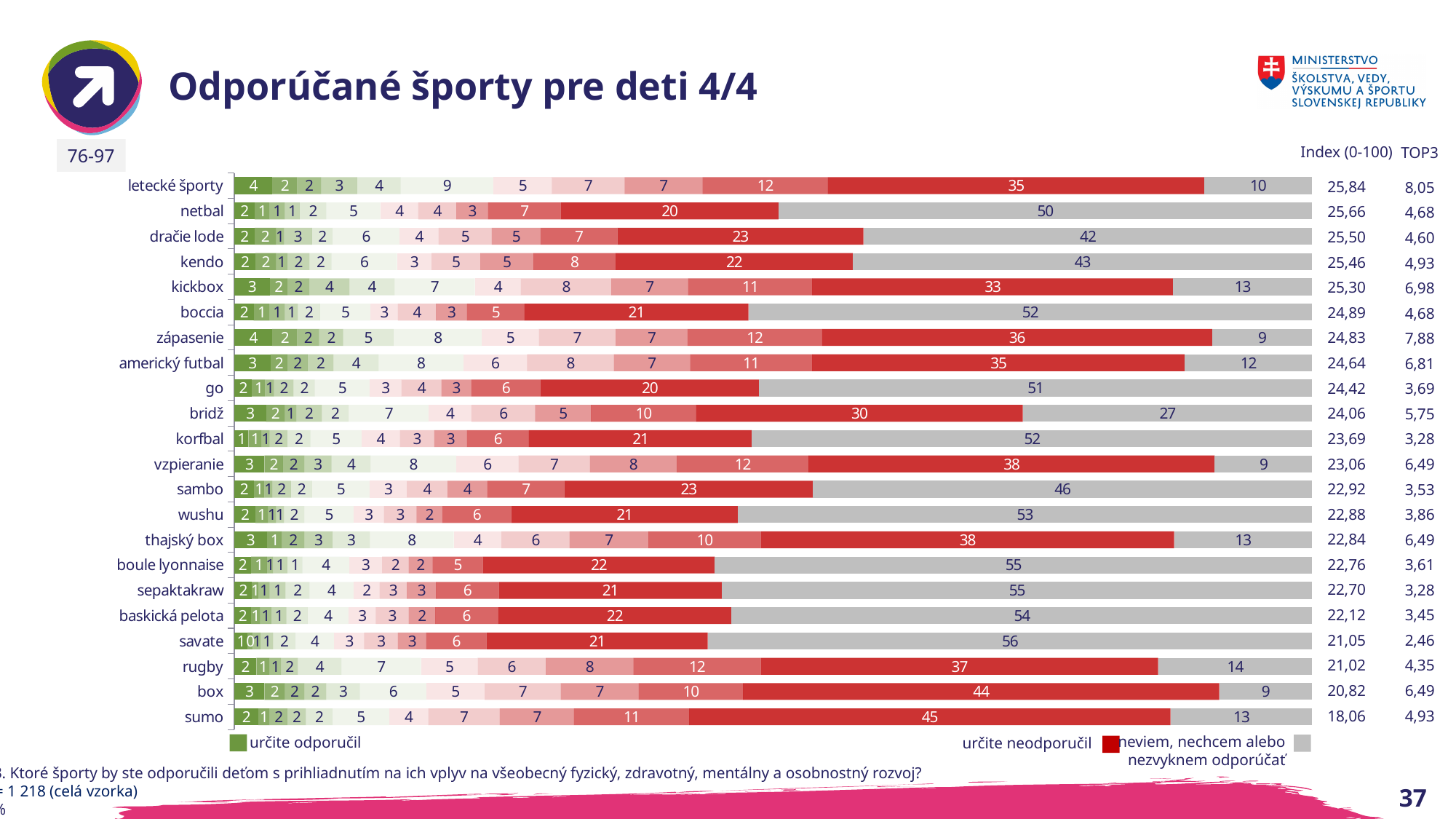
What is the value of the grey segment (neviem, nechcem alebo nezvyknem odporúčať) for savate? 56 What is the value of the red 'určite neodporučil' segment for box? 44 What is the difference between the grey segment values for boccia and netbal? 2 Which sport has the highest TOP3 value? letecké športy Which sport has the lowest Index (0-100) value? sumo What is the Index (0-100) value for letecké športy? 25,84 What is the TOP3 value for zápasenie? 7,88 How many sports are listed in the chart? 22 What kind of chart is shown on the slide? bar chart Which sport has the largest red 'určite neodporučil' segment? sumo Which has a larger red 'určite neodporučil' segment, kickbox or rugby? rugby Which sport has the largest grey 'neviem, nechcem alebo nezvyknem odporúčať' segment? savate